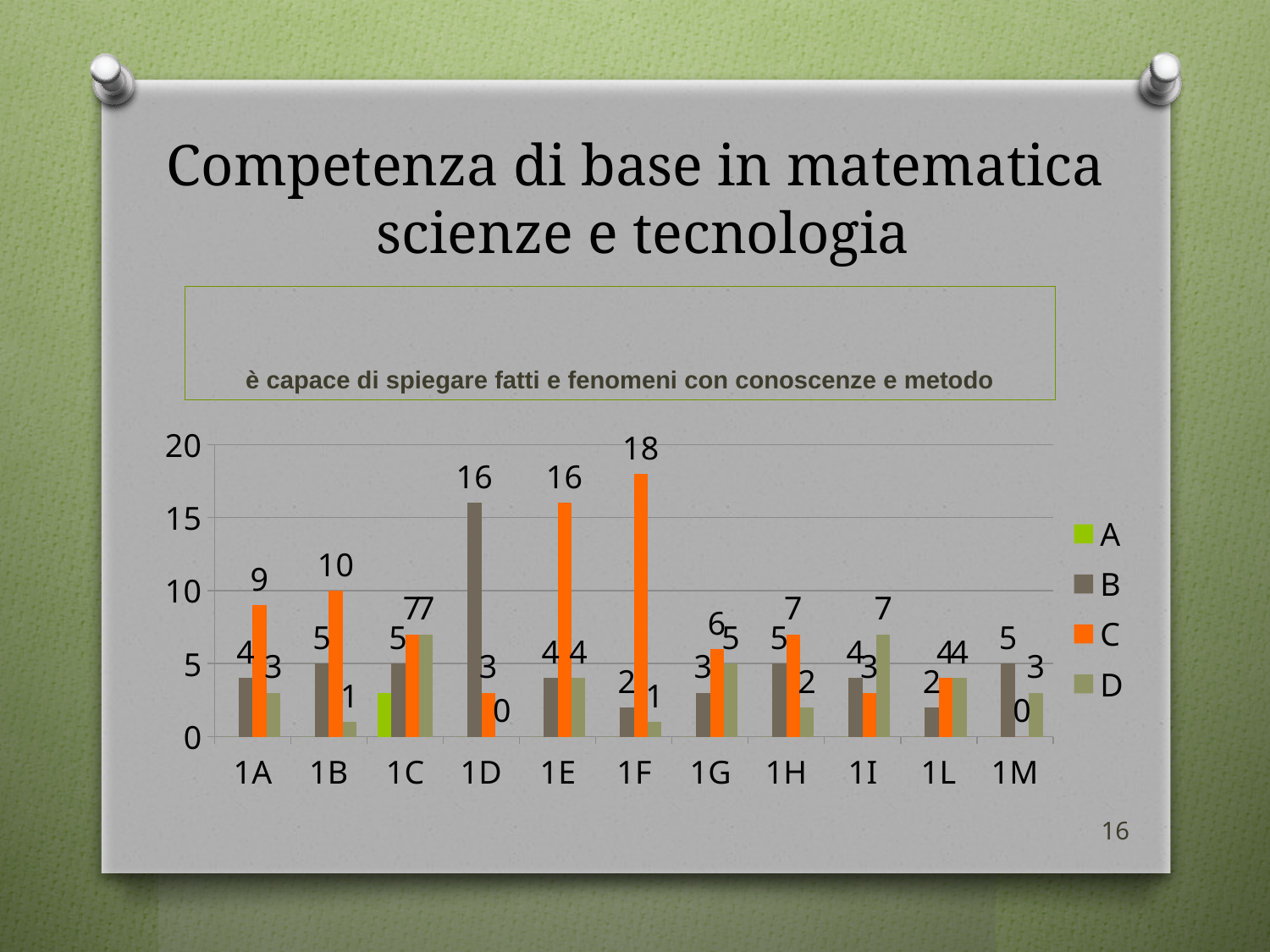
How many categories are shown on the x axis? 11 For category 1D, which is larger: series B or series C? B What is the value of series B for category 1D? 16 Which category has the lowest value for series D? 1D How many series does the legend list? 4 What is the difference between the series C value for 1F and the series C value for 1A? 9 What is the value of series C for category 1F? 18 What is the value of series D for category 1I? 7 What is the value of series C for category 1M? 0 What kind of chart is shown on the slide? bar chart Is the value of series A for category 1C greater or less than 5? less Which category has the highest value for series C? 1F